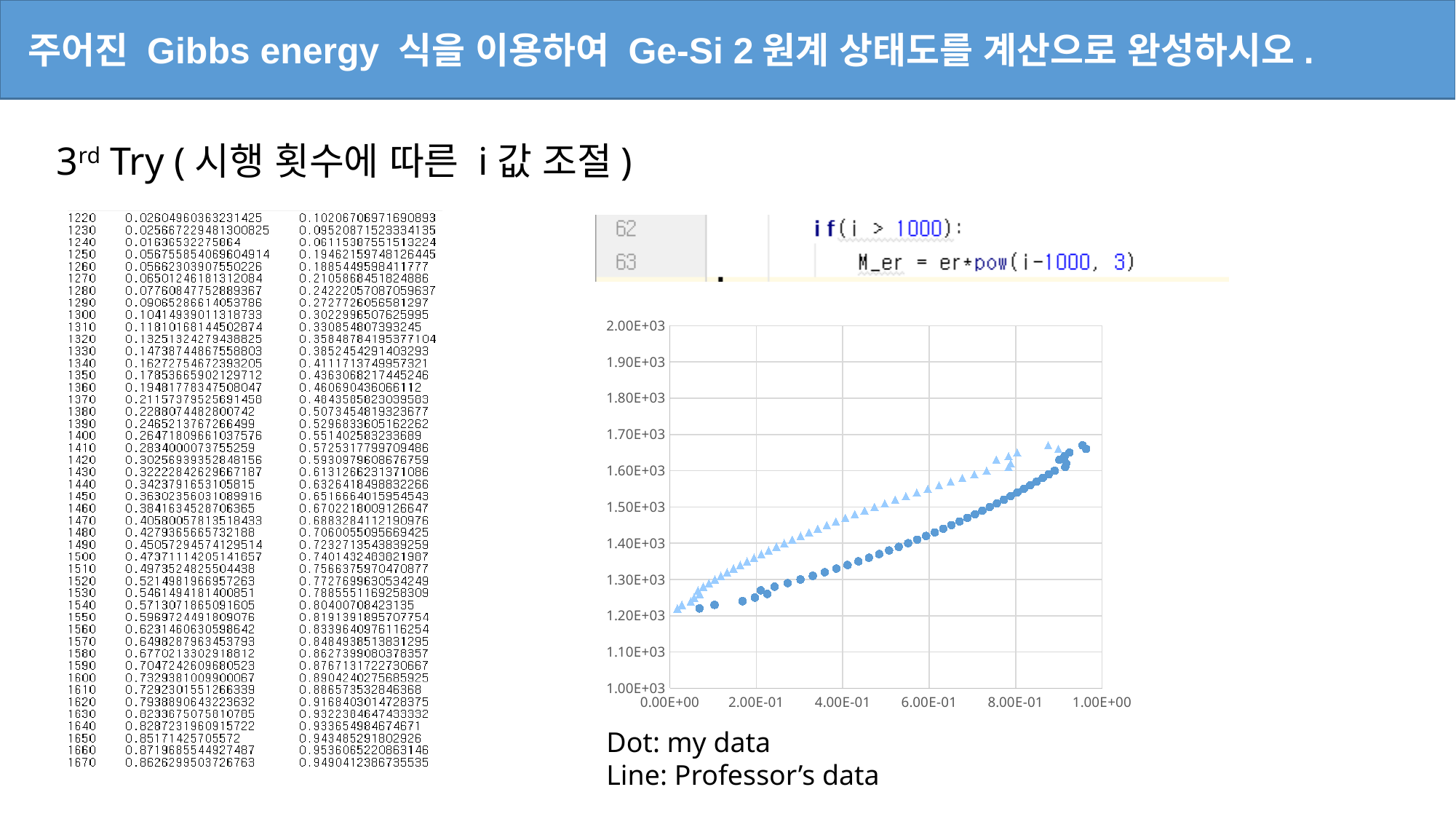
What is the highest tick value shown on the y-axis of the chart? 2.00E+03 At an x value of about 4.00E-01, which series has the higher y value: my data (dots) or Professor's data (triangles)? Professor's data (triangles) According to the text below the chart, what do the dots represent? my data Is the highest value of the dot series (my data) greater or less than 1.60E+03? greater Is the value of the dot series (my data) at x = 2.00E-01 greater or less than 1.30E+03? less Do the plotted values rise or fall as the x-axis value increases? rise Is the highest value of the triangle series (Professor's data) greater or less than 1.50E+03? greater What kind of chart is shown on the slide? scatter chart How many data series are plotted in the chart? 2